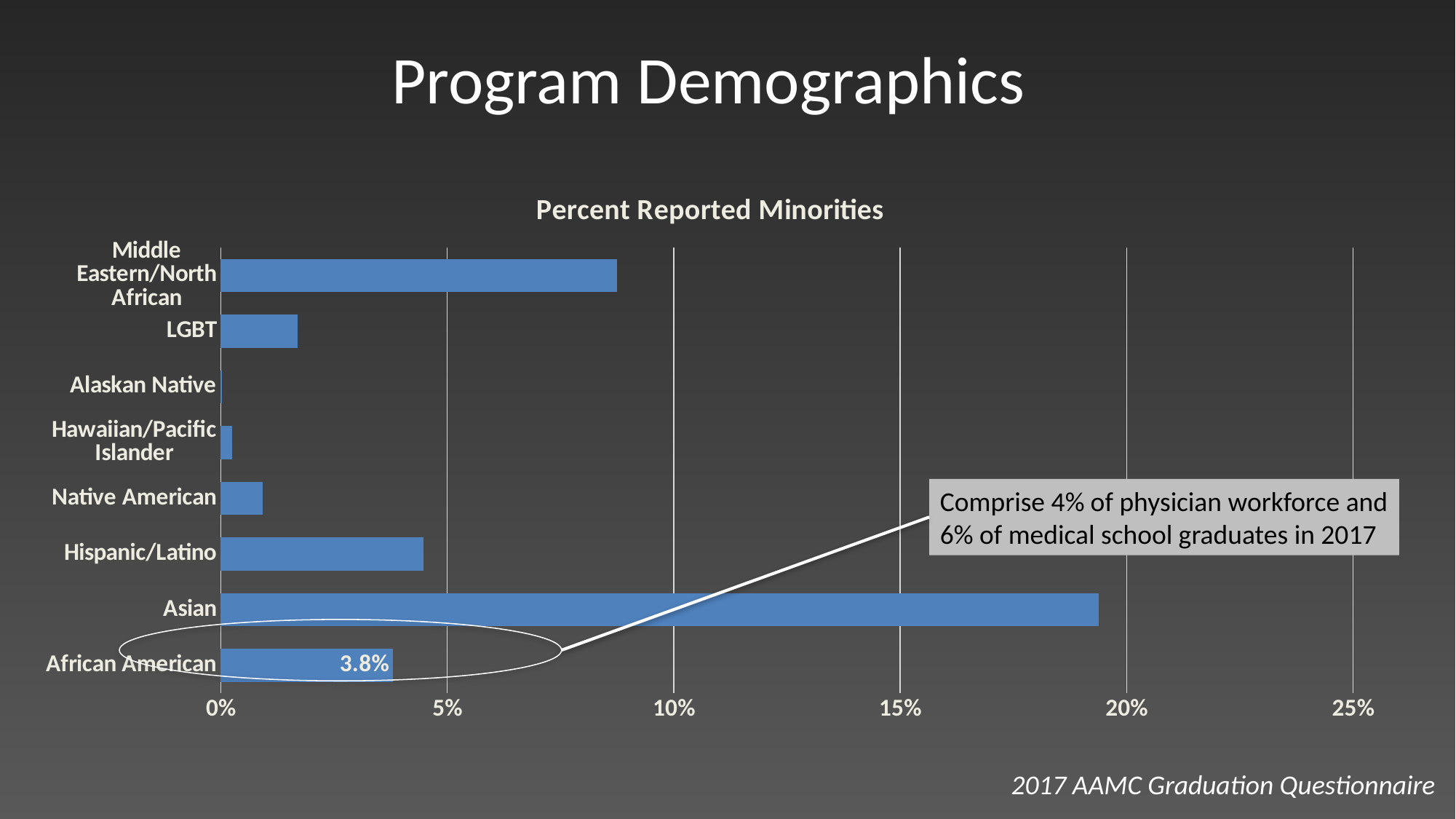
How many categories are shown in the Percent Reported Minorities chart? 8 Is the value for Asian greater or less than 15%? greater Which category has the highest value in the Percent Reported Minorities chart? Asian What is the title of the chart on the slide? Percent Reported Minorities What is the value for African American in the Percent Reported Minorities chart? 3.8% Which is larger, the value for Hispanic/Latino or the value for LGBT? Hispanic/Latino Which category has the lowest value in the Percent Reported Minorities chart? Alaskan Native Which is larger, the value for Asian or the value for Middle Eastern/North African? Asian Is the value for Middle Eastern/North African greater or less than 5%? greater Is the value for LGBT greater or less than 5%? less What kind of chart is shown on the slide? Bar chart